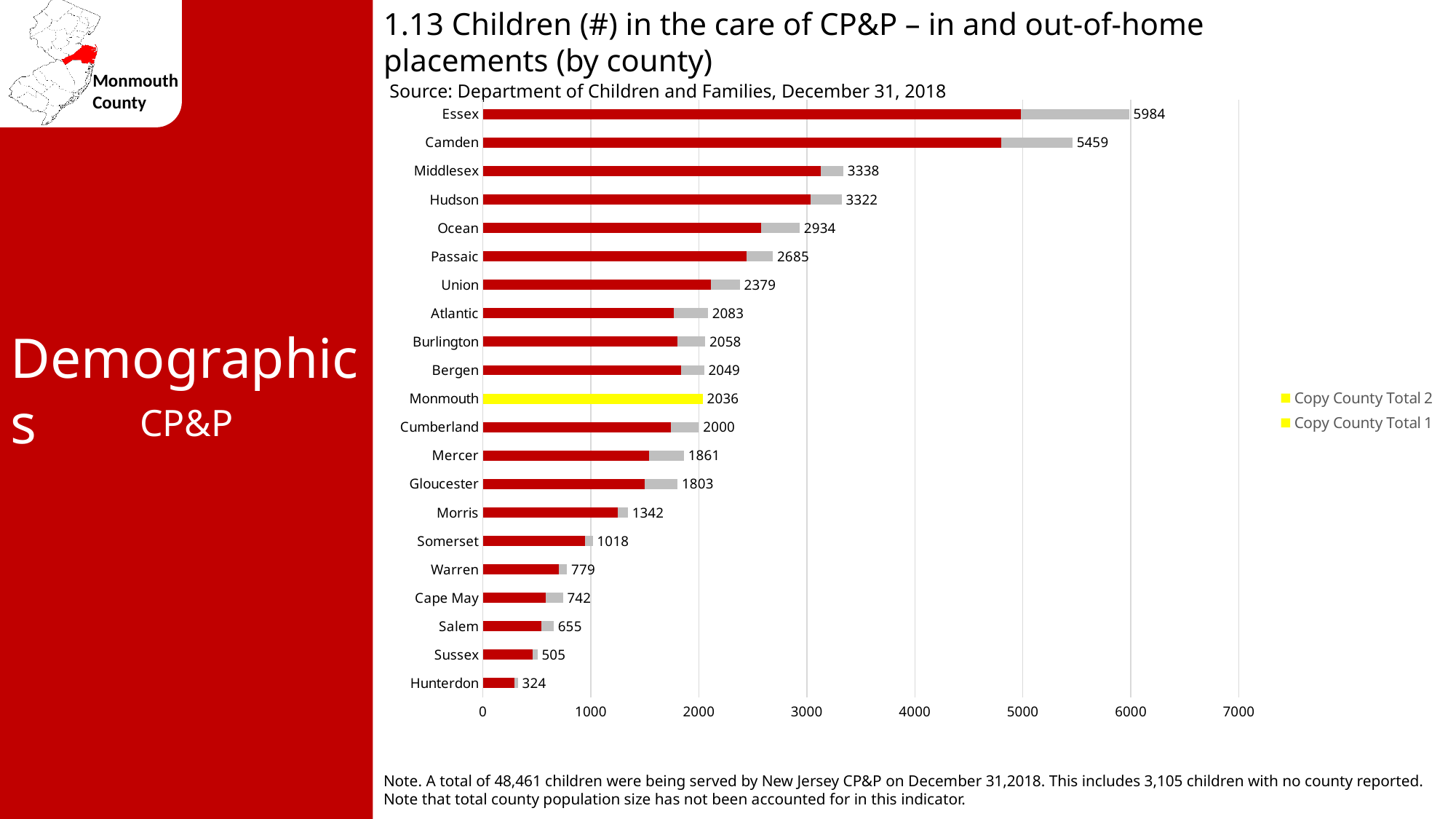
What is the value shown for Hunterdon County? 324 What is the value shown for Essex County? 5984 What is the difference between the values for Monmouth and Cumberland? 36 Is the value for Middlesex greater or less than 3000? greater How many counties are shown in the chart? 21 Which county has the highest number of children in the care of CP&P? Essex What is the difference between the values for Essex and Camden? 525 What is the total number of children in the care of CP&P shown for Monmouth County? 2036 What type of chart is used on this slide? Bar chart Which county has the lowest number of children in the care of CP&P? Hunterdon How many entries does the legend list? 2 Which county has a larger value, Ocean or Passaic? Ocean